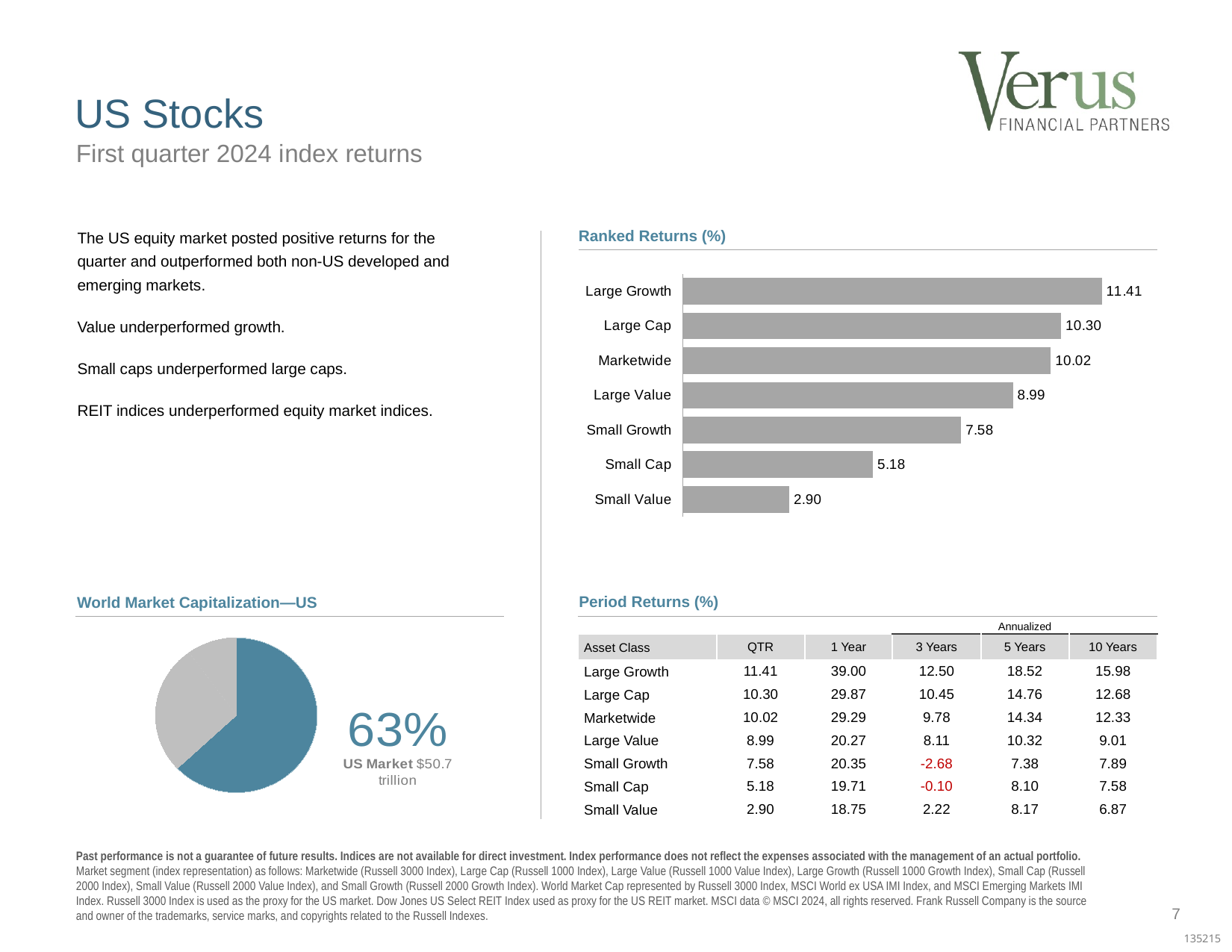
What kind of chart is the Ranked Returns (%) chart? Bar chart In the Ranked Returns (%) chart, which category has the lowest value? Small Value In the Ranked Returns (%) chart, which is larger, Large Value or Small Growth? Large Value In the Ranked Returns (%) chart, what is the value for Marketwide? 10.02 How many categories are shown in the Ranked Returns (%) chart? 7 What kind of chart is the World Market Capitalization—US chart? Pie chart In the Ranked Returns (%) chart, what is the difference between Large Cap and Small Cap? 5.12 In the Ranked Returns (%) chart, what is the value for Small Cap? 5.18 In the World Market Capitalization—US pie chart, what share does the US Market represent? 63% In the Ranked Returns (%) chart, what is the value for Large Growth? 11.41 In the World Market Capitalization—US chart, what is the US Market value in dollars? $50.7 trillion In the Ranked Returns (%) chart, which category has the highest value? Large Growth